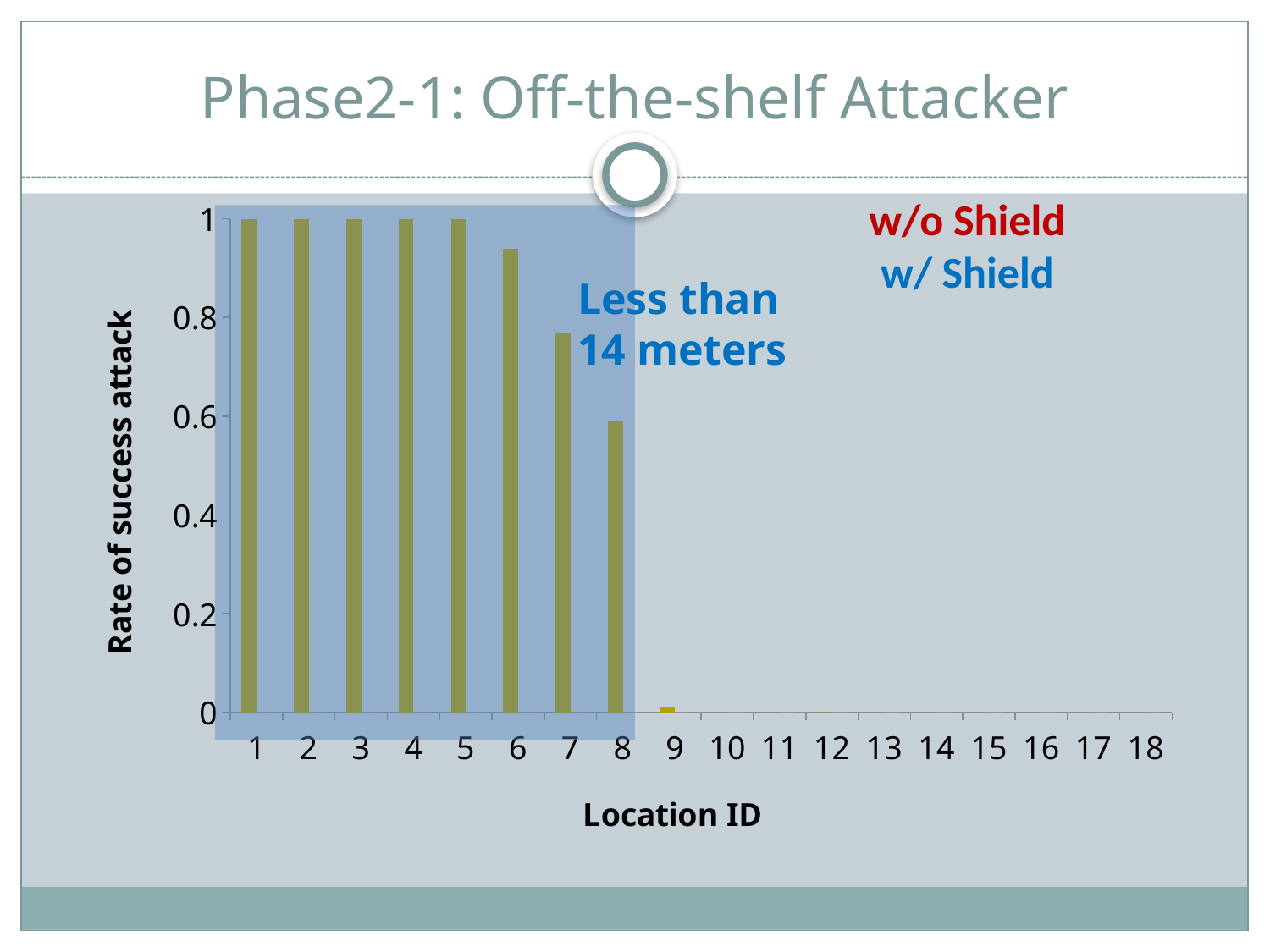
Is the value for Location ID 7 greater or less than 0.8? less What is the rate of success attack for Location ID 1? 1 What is the title of the y axis? Rate of success attack What is the rate of success attack for Location ID 5? 1 Which has a higher rate of success attack, Location ID 6 or Location ID 7? Location ID 6 Do the values rise or fall from Location ID 5 to Location ID 9? fall Is the value for Location ID 8 greater or less than 0.4? greater Is the value for Location ID 6 greater or less than 0.8? greater How many Location IDs are shown on the x axis? 18 Which has a higher rate of success attack, Location ID 7 or Location ID 8? Location ID 7 What kind of chart is shown on the slide? bar chart